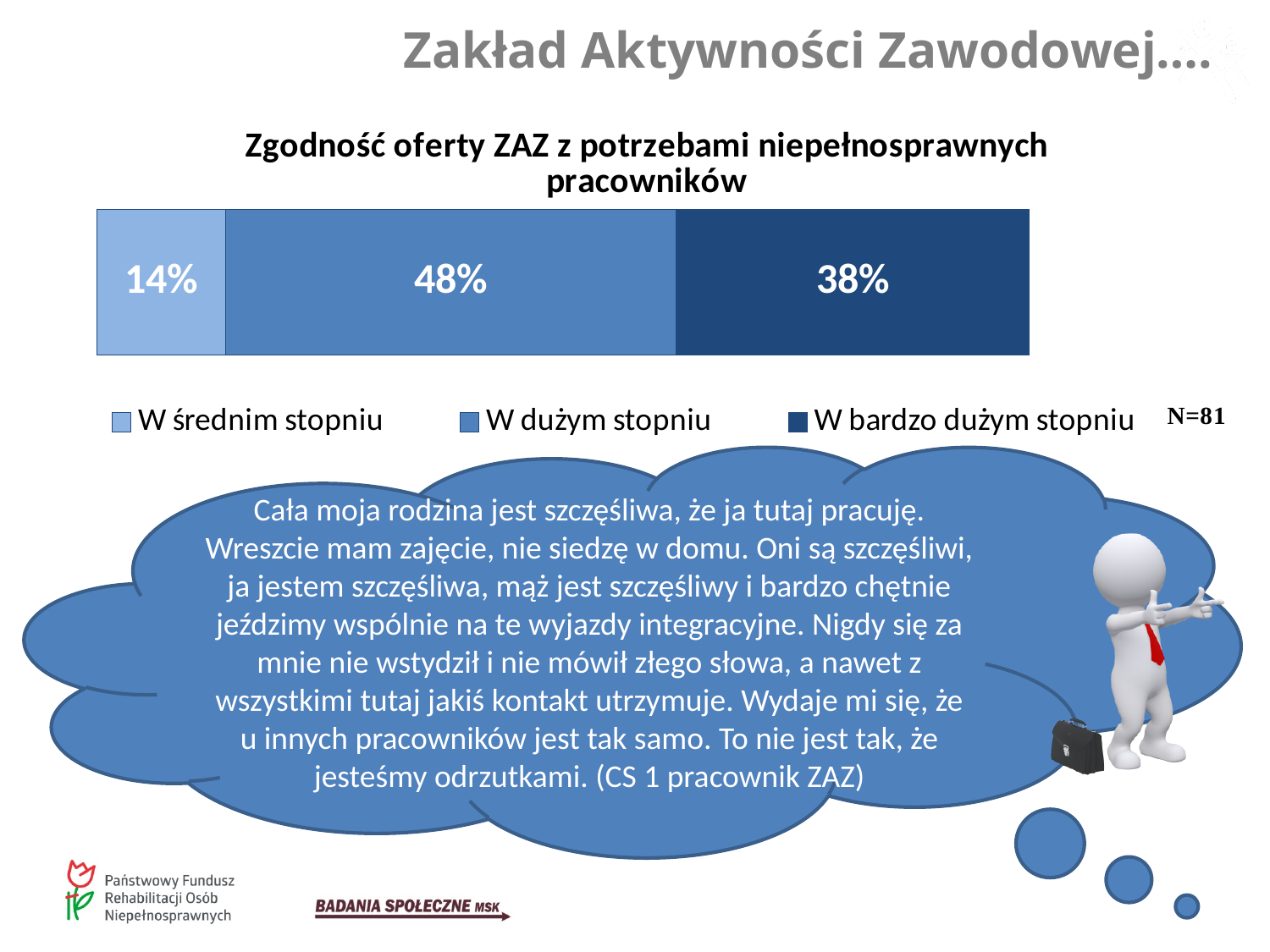
What is the difference between the "W bardzo dużym stopniu" and "W średnim stopniu" values? 24% Which category has the smallest share of the bar? W średnim stopniu What kind of chart is shown on the slide? Stacked bar chart Which category has the largest share of the bar? W dużym stopniu Which is larger, the value for "W bardzo dużym stopniu" or for "W średnim stopniu"? W bardzo dużym stopniu What is the sample size (N) stated next to the chart? N=81 What percentage is shown for "W bardzo dużym stopniu"? 38% How many segments make up the stacked bar? 3 What percentage is shown for "W dużym stopniu"? 48% What is the difference between the "W dużym stopniu" and "W bardzo dużym stopniu" values? 10% What percentage is shown for "W średnim stopniu"? 14% How many series does the legend list? 3